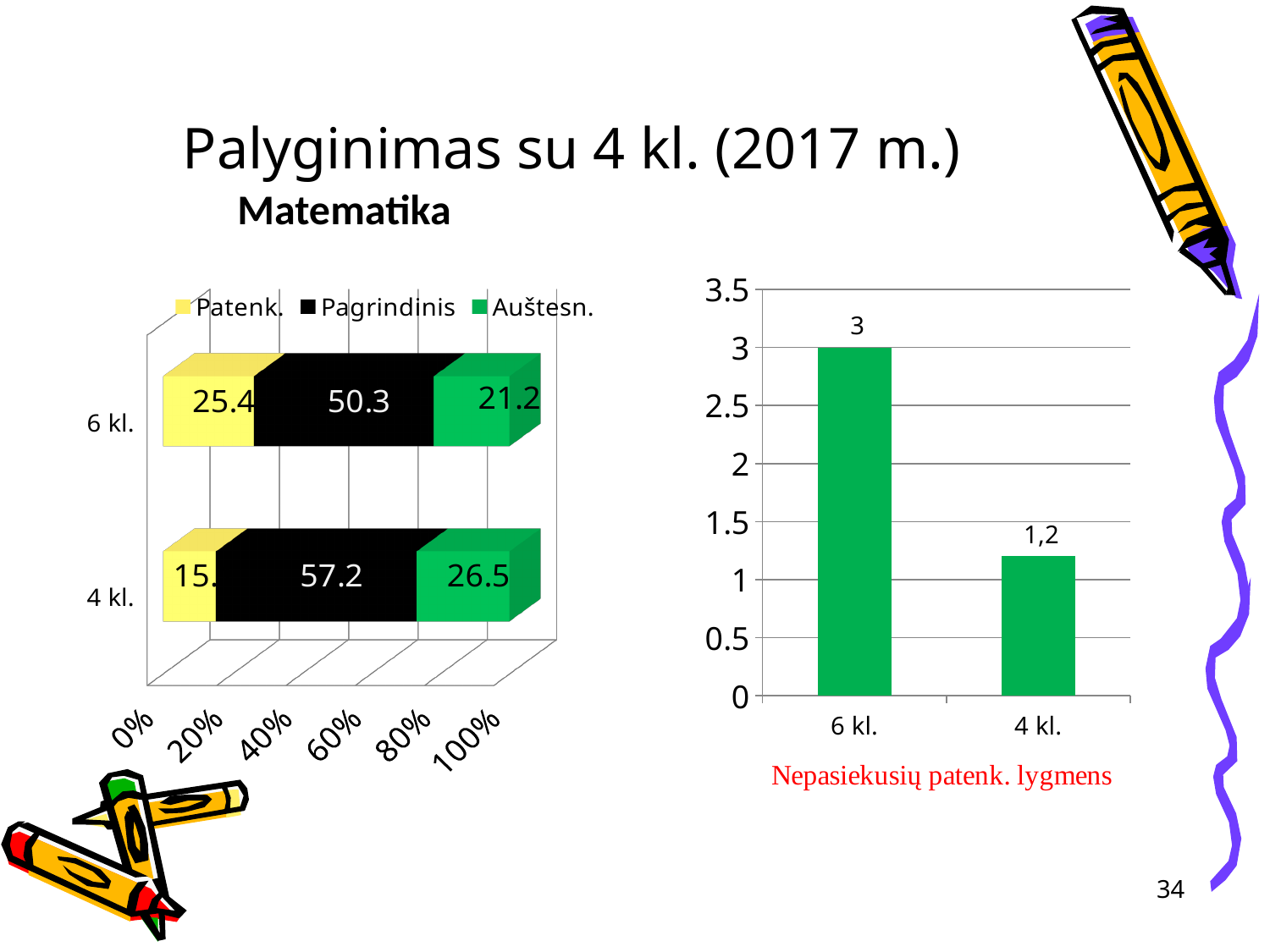
In the left chart, which series has the highest value for 6 kl.? Pagrindinis In the left chart, which is larger: the Auštesn. value for 6 kl. or for 4 kl.? 4 kl. In the left chart, what is the difference between the Pagrindinis values for 4 kl. and 6 kl.? 6.9 In the left chart, what is the Patenk. value for 6 kl.? 25.4 In the left chart, what is the Auštesn. value for 4 kl.? 26.5 In the left chart, what is the Pagrindinis value for 6 kl.? 50.3 In the left chart, what is the Pagrindinis value for 4 kl.? 57.2 In the right chart, what is the value for 6 kl.? 3 What kind of chart is the right chart? Bar chart In the right chart, which category has the lowest value? 4 kl. In the right chart, what is the value for 4 kl.? 1,2 How many series does the legend of the left chart list? 3